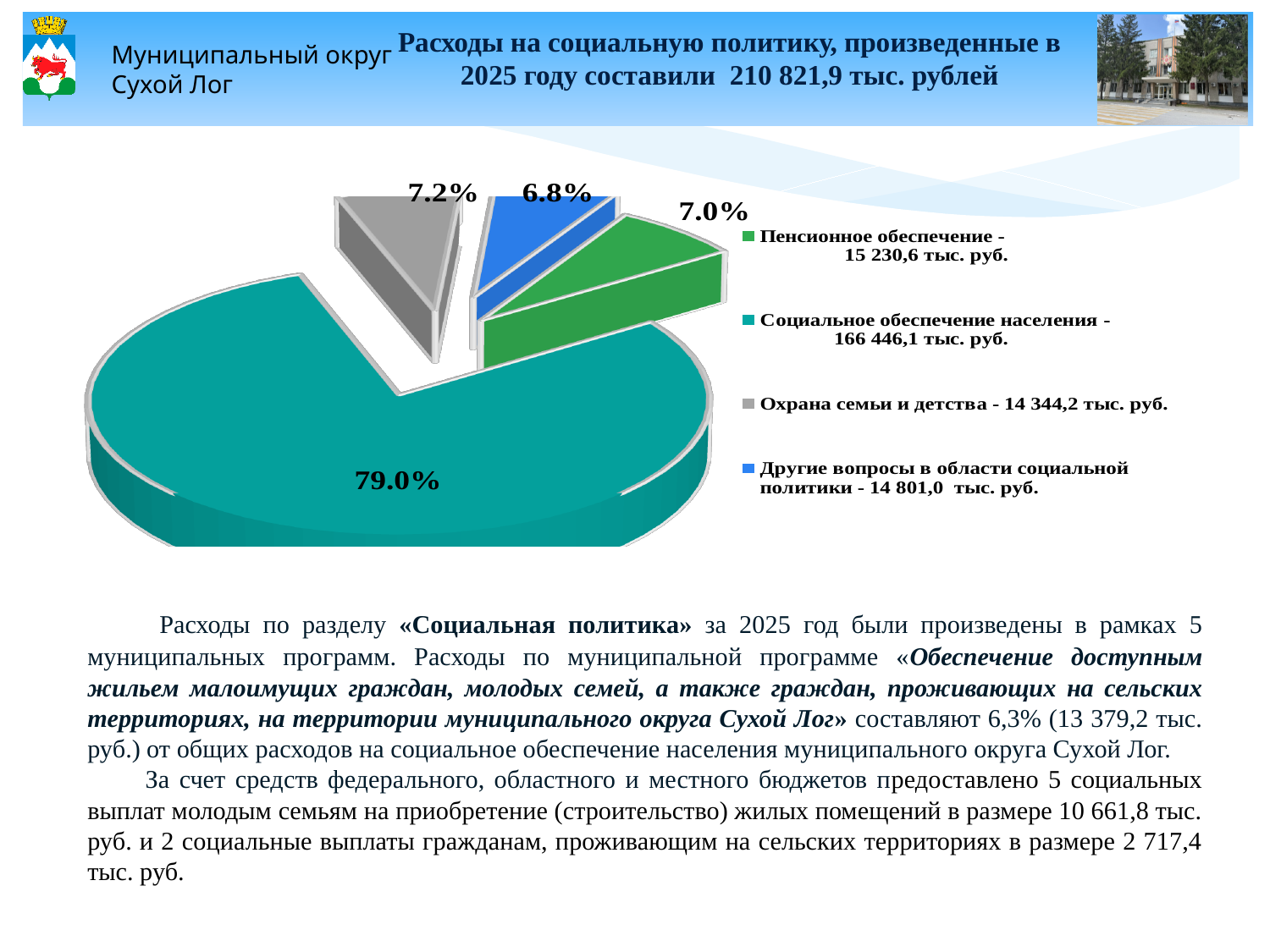
How many categories does the pie chart show? 4 What value does the legend give for «Другие вопросы в области социальной политики»? 14 801,0 тыс. руб. What value does the legend give for «Охрана семьи и детства»? 14 344,2 тыс. руб. Which is larger: «Пенсионное обеспечение» or «Охрана семьи и детства»? Пенсионное обеспечение What value does the legend give for «Социальное обеспечение населения»? 166 446,1 тыс. руб. What is the difference between «Другие вопросы в области социальной политики» and «Охрана семьи и детства» in тыс. руб.? 456,8 Which category has the smallest value in the pie chart? Охрана семьи и детства What kind of chart is shown on the slide? Pie chart Which category has the largest value in the pie chart? Социальное обеспечение населения What value does the legend give for «Пенсионное обеспечение»? 15 230,6 тыс. руб. What is the difference between «Социальное обеспечение населения» and «Пенсионное обеспечение» in тыс. руб.? 151 215,5 What share of the pie does the largest slice (Социальное обеспечение населения) take? 79.0%